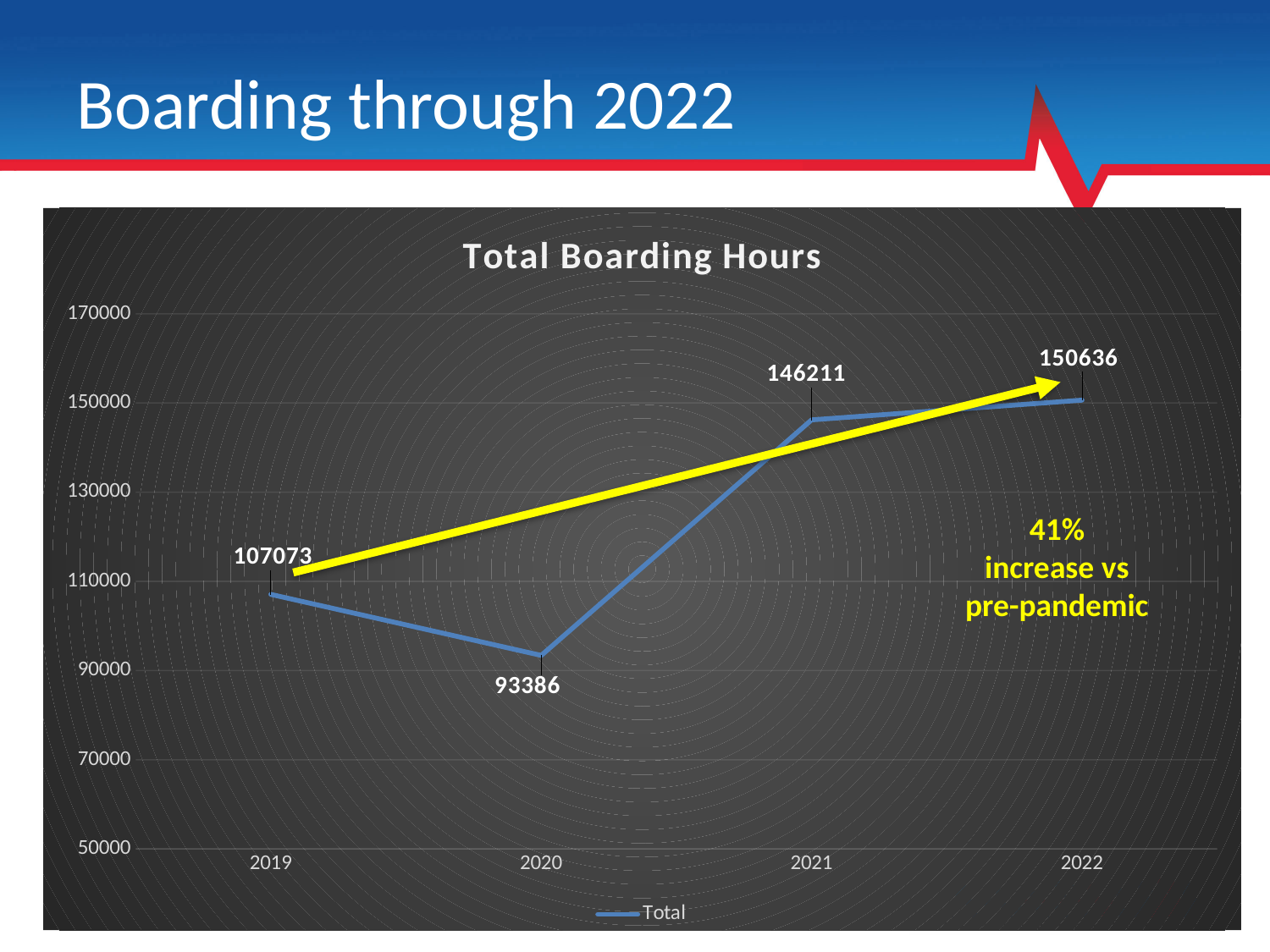
What is the difference in total boarding hours between 2021 and 2020? 52825 What is the title of the chart? Total Boarding Hours Which year has more total boarding hours, 2019 or 2021? 2021 How many years are plotted on the chart? 4 What is the total boarding hours value for 2019? 107073 Which year has the lowest total boarding hours? 2020 What kind of chart is shown on the slide? Line chart What is the difference in total boarding hours between 2022 and 2019? 43563 What is the total boarding hours value for 2022? 150636 What is the total boarding hours value for 2021? 146211 What is the total boarding hours value for 2020? 93386 Which year has the highest total boarding hours? 2022